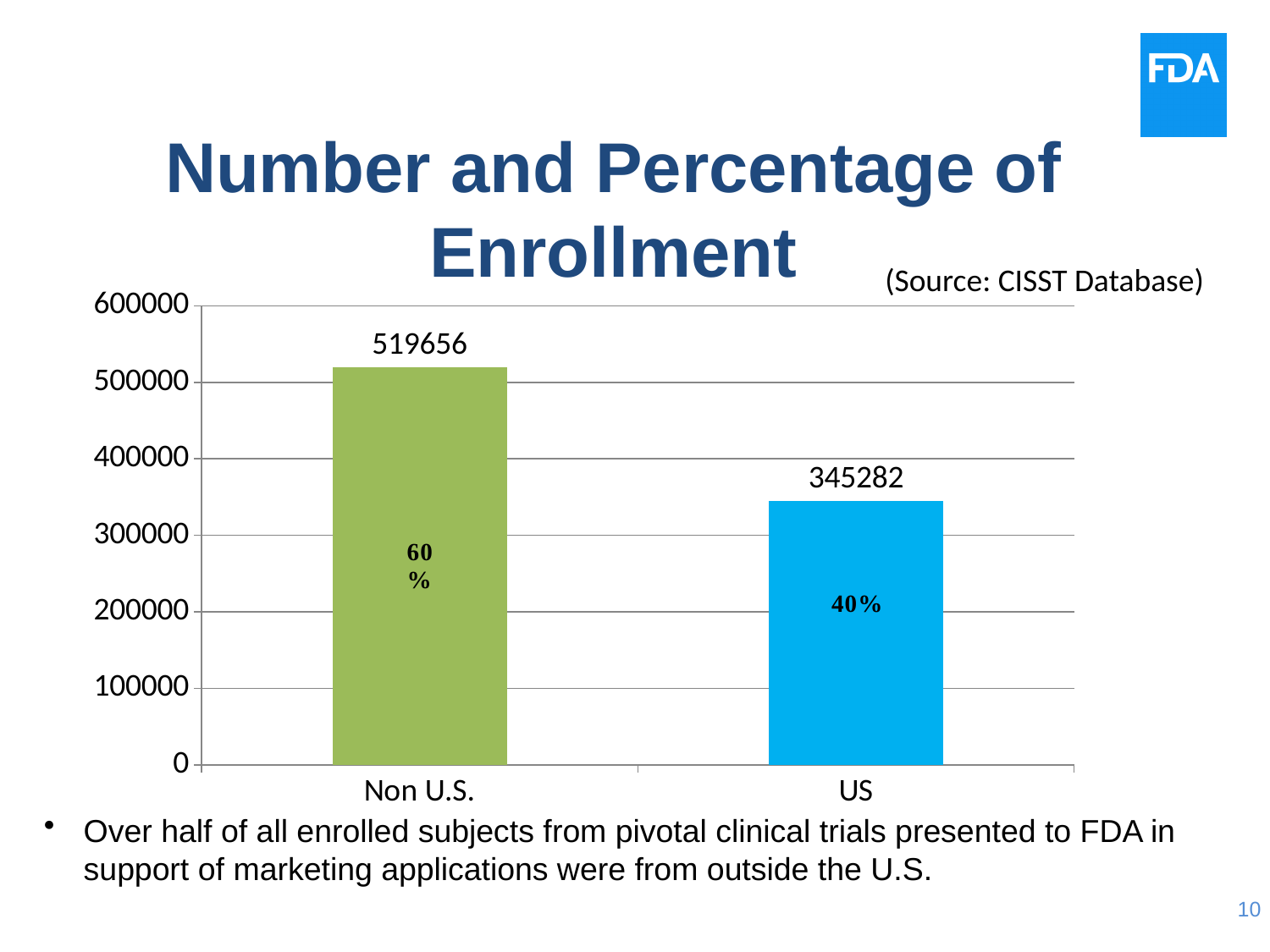
What is the enrollment value for US? 345282 Which is larger, the enrollment for Non U.S. or for US? Non U.S. What is the enrollment value for Non U.S.? 519656 Is the value for US greater or less than 400000? less Which category has the lowest enrollment? US What is the difference in enrollment between Non U.S. and US? 174374 What percentage label is shown inside the Non U.S. bar? 60% Which category has the highest enrollment? Non U.S. How many categories are shown on the x axis? 2 What kind of chart is shown on the slide? bar chart What percentage label is shown inside the US bar? 40% What is the title of the chart? Number and Percentage of Enrollment